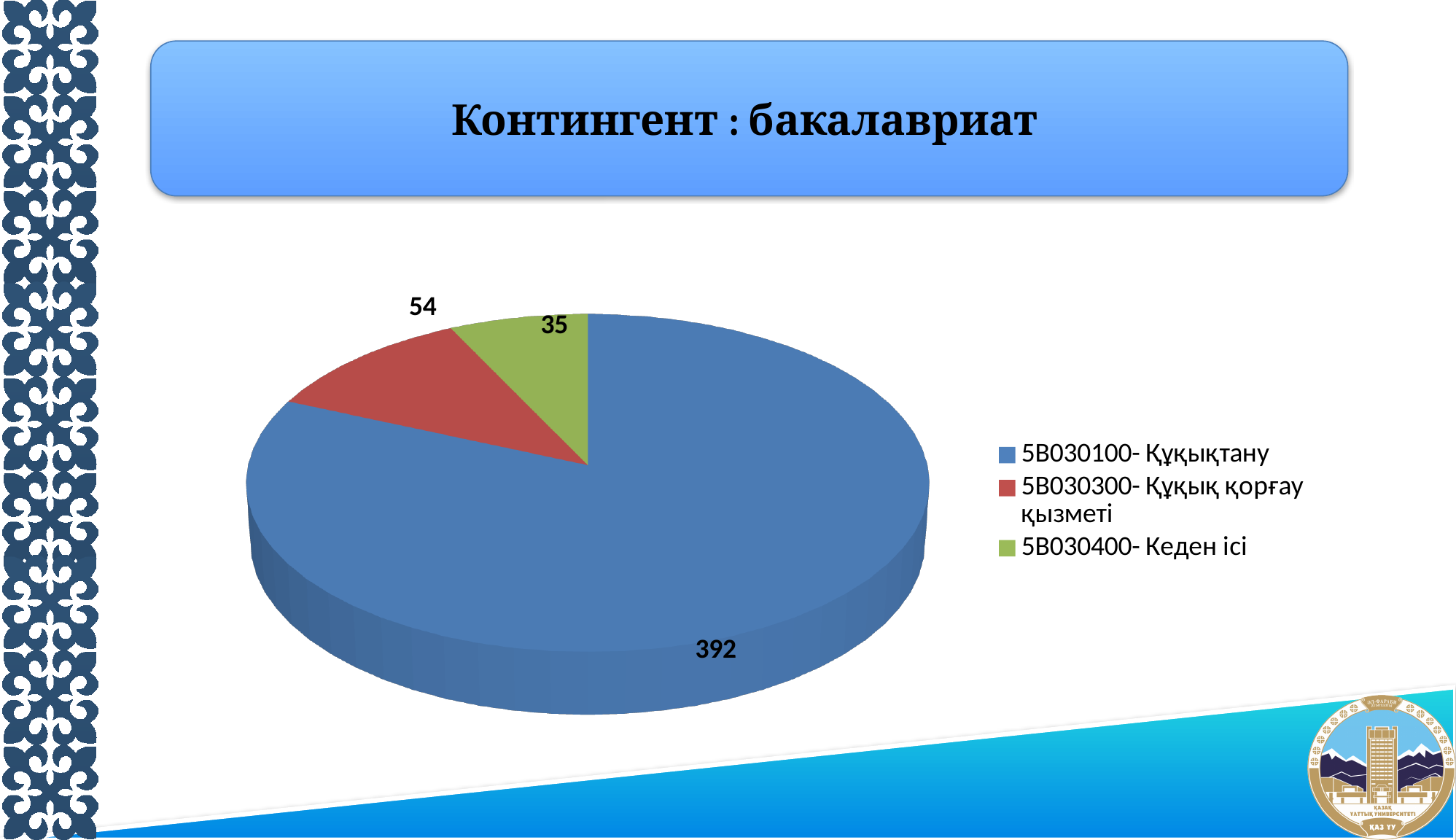
Which is larger, the value for 5B030300- Құқық қорғау қызметі or the value for 5B030400- Кеден ісі? 5B030300- Құқық қорғау қызметі What type of chart is shown on the slide? Pie chart What is the value for 5B030100- Құқықтану? 392 What is the title of the slide containing the pie chart? Контингент : бакалавриат Which category has the smallest slice of the pie? 5B030400- Кеден ісі What is the value for 5B030400- Кеден ісі? 35 What is the value for 5B030300- Құқық қорғау қызметі? 54 How many categories does the pie chart show? 3 What is the total of all slices in the pie chart? 481 Which category has the largest slice of the pie? 5B030100- Құқықтану What is the difference between the values for 5B030100- Құқықтану and 5B030300- Құқық қорғау қызметі? 338 What is the difference between the values for 5B030300- Құқық қорғау қызметі and 5B030400- Кеден ісі? 19